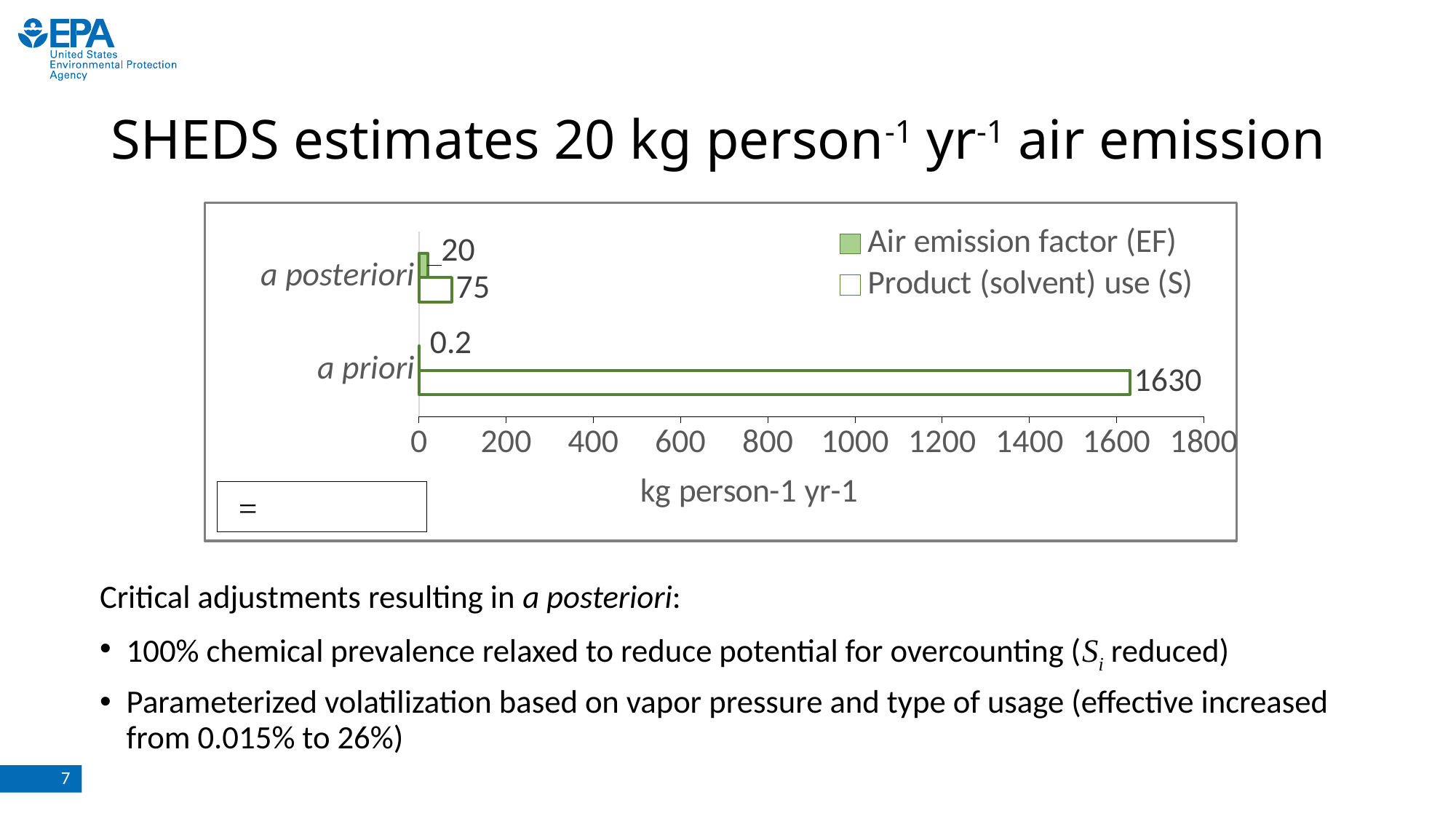
How many categories are shown on the chart? 2 Which category has the highest Product (solvent) use (S) value? a priori What is the Air emission factor (EF) value for a priori? 0.2 Is the Product (solvent) use (S) value for a priori greater or less than 1400? greater Which is larger: the Air emission factor (EF) for a posteriori or for a priori? a posteriori What is the Air emission factor (EF) value for a posteriori? 20 What is the difference between the Product (solvent) use (S) values for a priori and a posteriori? 1555 What kind of chart is shown on the slide? bar chart How many series does the legend list? 2 Which category has the lowest Air emission factor (EF) value? a priori What is the Product (solvent) use (S) value for a posteriori? 75 What is the Product (solvent) use (S) value for a priori? 1630